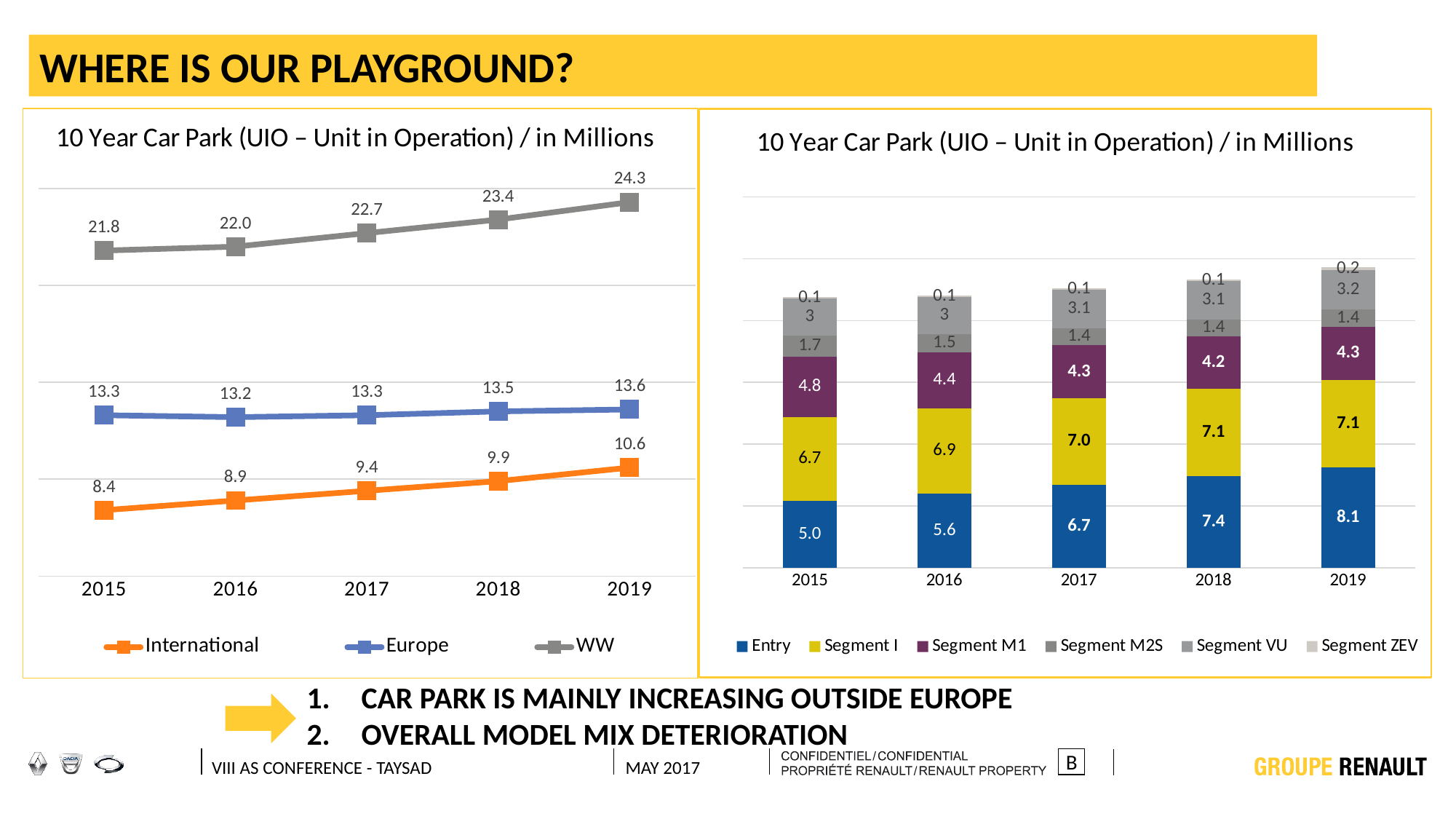
In the left chart, what is the WW value for 2019? 24.3 In the right chart, which is larger for 2019: Entry or Segment I? Entry In the right chart, what is the Entry value for 2017? 6.7 How many series does the legend of the left chart list? 3 In the left chart, what is the International value for 2015? 8.4 How many series does the legend of the right chart list? 6 What kind of chart is the right chart on the slide? bar chart In the left chart, does the International series rise or fall from 2015 to 2019? rises In the right chart, what is the Segment M1 value for 2015? 4.8 What kind of chart is the left chart on the slide? line chart In the left chart, what is the difference between the WW values for 2019 and 2015? 2.5 In the right chart, what is the total of the stacked bar for 2019? 24.3